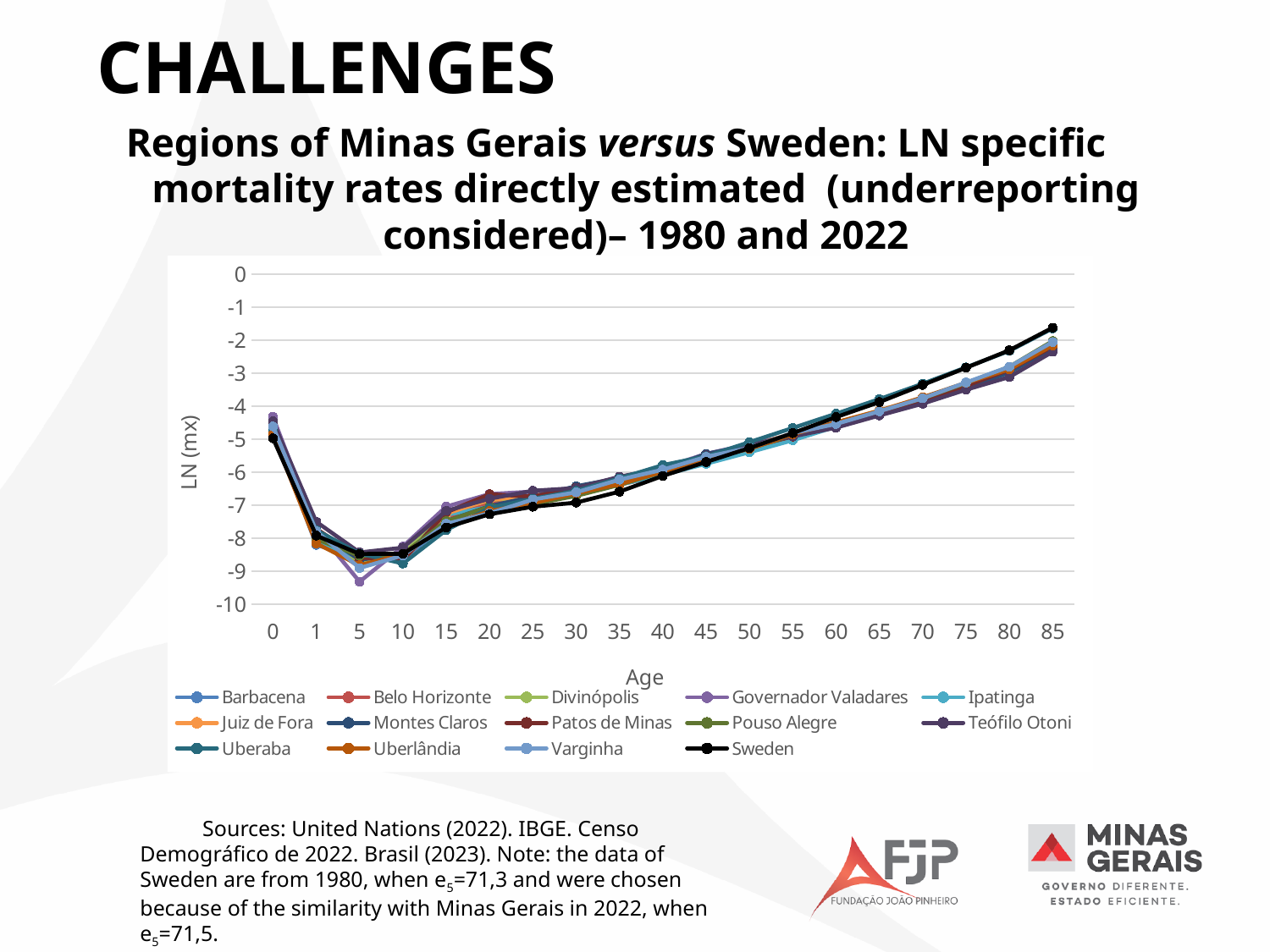
What kind of chart is shown on the slide? line chart What is the label of the vertical axis? LN (mx) How many series does the chart legend list? 14 At which age does the Governador Valadares series reach its lowest value? 5 Is the value for Governador Valadares at age 5 greater or less than -9? less Is the value for Sweden at age 15 greater or less than -7? less What is the label of the horizontal axis? Age Is the value for Sweden at age 85 greater or less than -2? greater Which series has the lowest value at age 5? Governador Valadares Do the values for Sweden rise or fall from age 5 to age 85? rise Which series has the highest value at age 85? Sweden How many age points are plotted along the x axis? 19